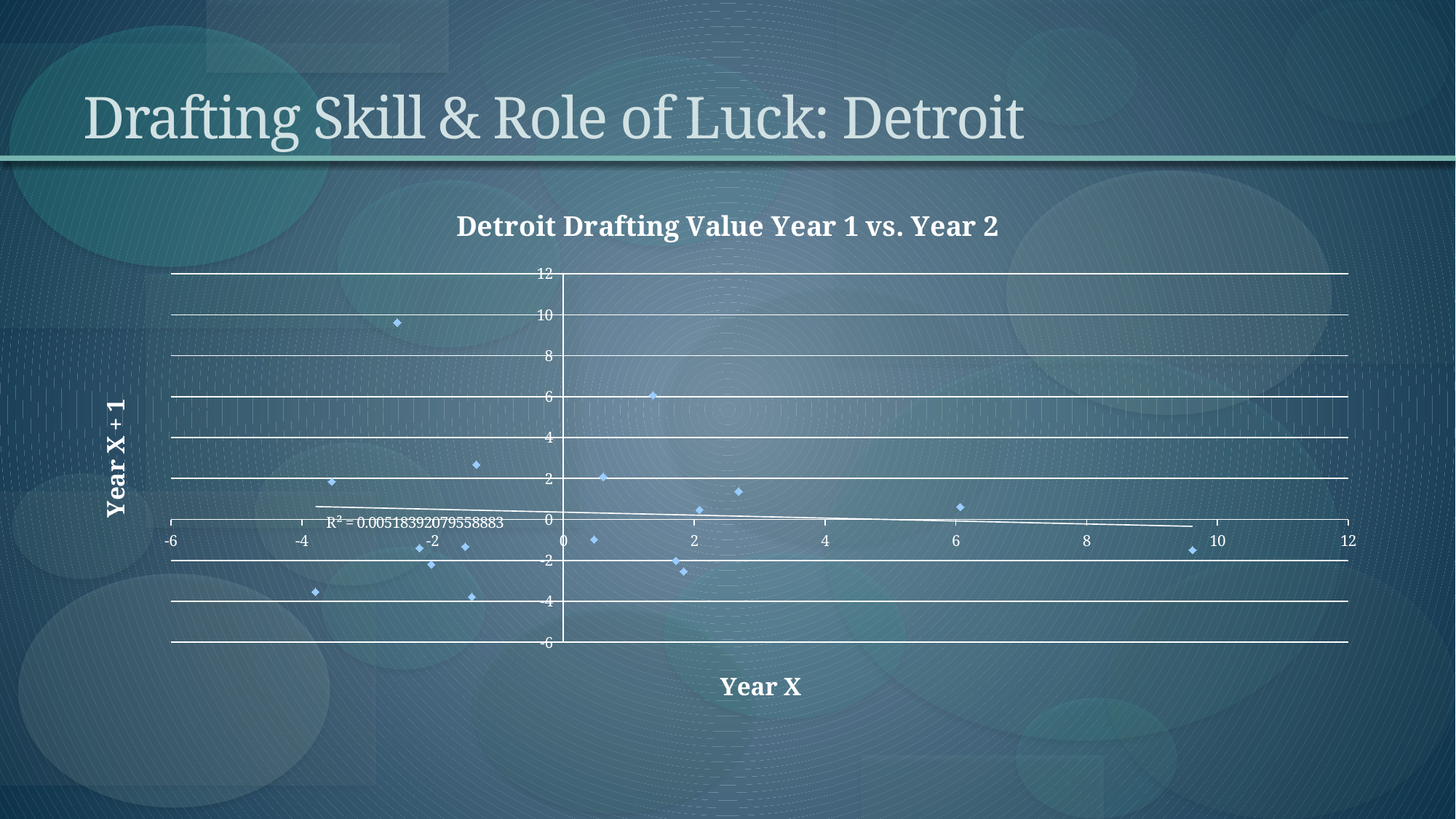
What is the label of the vertical axis of the chart? Year X + 1 How many data points are plotted on the chart? 17 Does the trendline on the chart rise or fall as Year X increases? Fall Is the Year X + 1 value of the lowest point on the chart greater or less than -2? less Is the Year X + 1 value of the point with the largest Year X value greater or less than 0? less What is the minimum value shown on the horizontal axis of the chart? -6 What is the maximum value shown on the vertical axis of the chart? 12 Is the Year X + 1 value of the highest point on the chart greater or less than 8? greater What is the title of the chart? Detroit Drafting Value Year 1 vs. Year 2 What R² value is printed on the chart? R² = 0.00518392079558883 What kind of chart is shown on the slide? Scatter chart